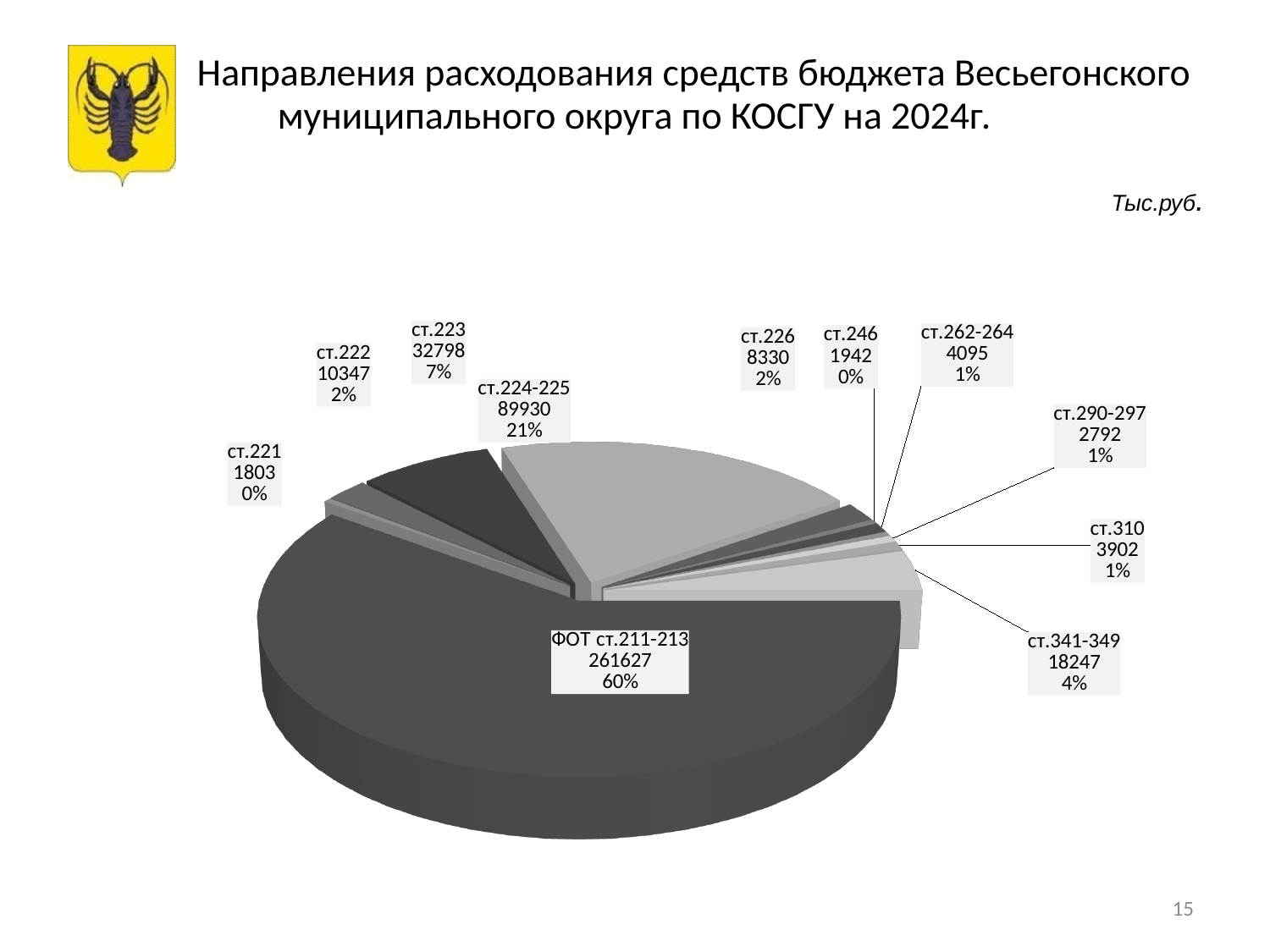
How many categories are shown in the pie chart? 11 What is the value for ФОТ ст.211-213? 261627 What is the difference between the values for ст.224-225 and ст.223? 57132 What share of the pie does ст.223 represent? 7% What unit of measurement is indicated on the slide for the chart values? Тыс.руб. Which is larger, the value for ст.222 or the value for ст.226? ст.222 What is the value for ст.224-225? 89930 What share of the pie does ФОТ ст.211-213 represent? 60% Which category has the smallest value? ст.221 What kind of chart is shown on the slide? Pie chart Which category has the largest value? ФОТ ст.211-213 What is the value for ст.341-349? 18247